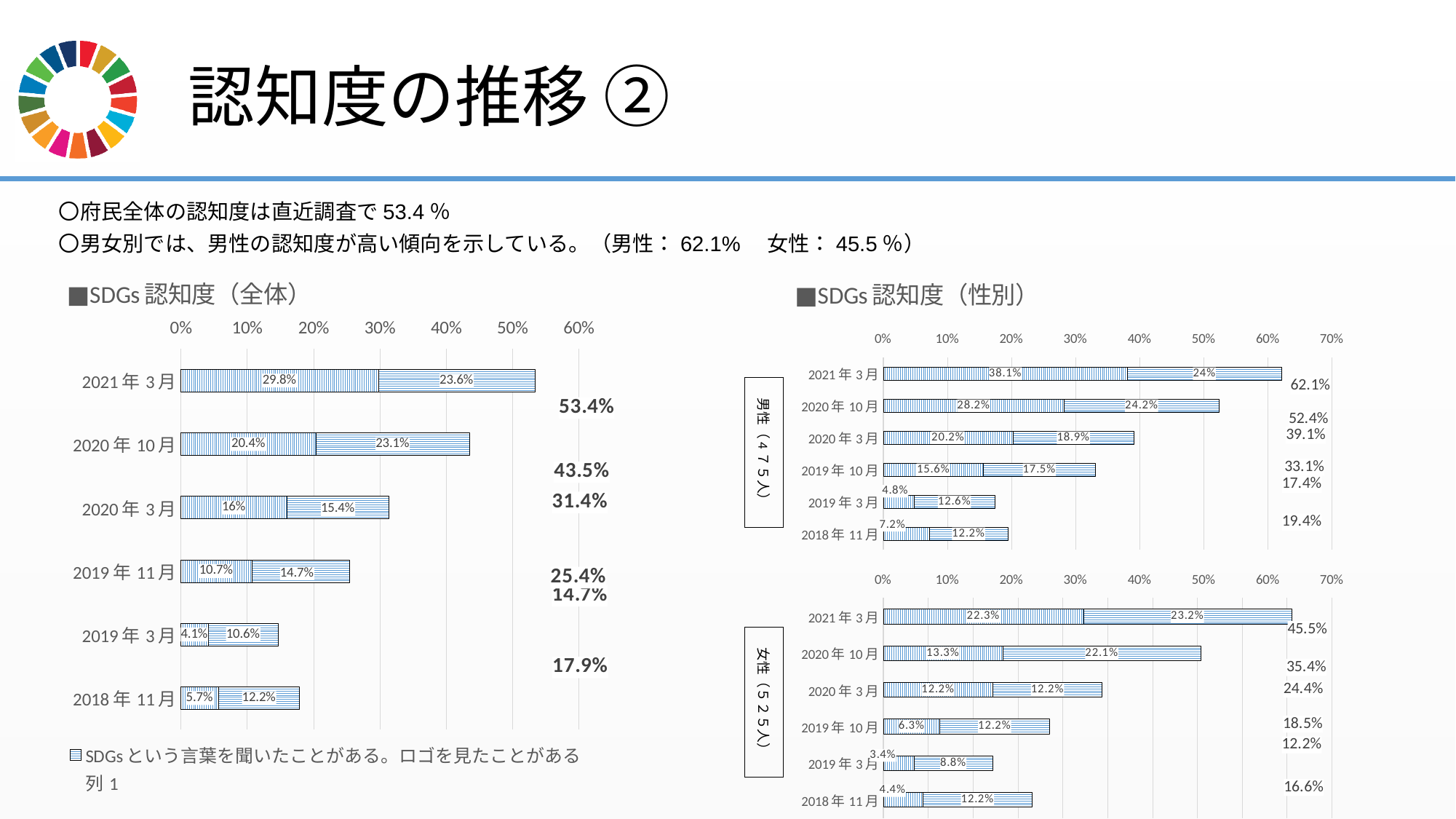
In the SDGs認知度（全体） chart, which period has the longest bar? 2021年3月 In the SDGs認知度（性別） chart, which is larger for 2021年3月: the 男性 total or the 女性 total? 男性 In the SDGs認知度（性別） chart, which period has the shortest bar for 女性? 2019年3月 In the SDGs認知度（全体） chart, how many periods are plotted? 6 In the SDGs認知度（全体） chart, what is the difference between the totals for 2021年3月 and 2020年10月? 9.9% In the SDGs認知度（性別） chart, what is the first-segment value for 女性 in 2020年10月? 13.3% In the SDGs認知度（性別） chart, what is the second-segment value for 男性 in 2019年10月? 17.5% In the SDGs認知度（全体） chart, what is the first-segment value for 2021年3月? 29.8% In the SDGs認知度（性別） chart, what is the total for 男性 in 2021年3月? 62.1% In the SDGs認知度（全体） chart, which period has the shortest bar? 2019年3月 What type of chart is the SDGs認知度（全体） chart? Stacked bar chart In the SDGs認知度（全体） chart, what is the total shown for the 2020年10月 bar? 43.5%